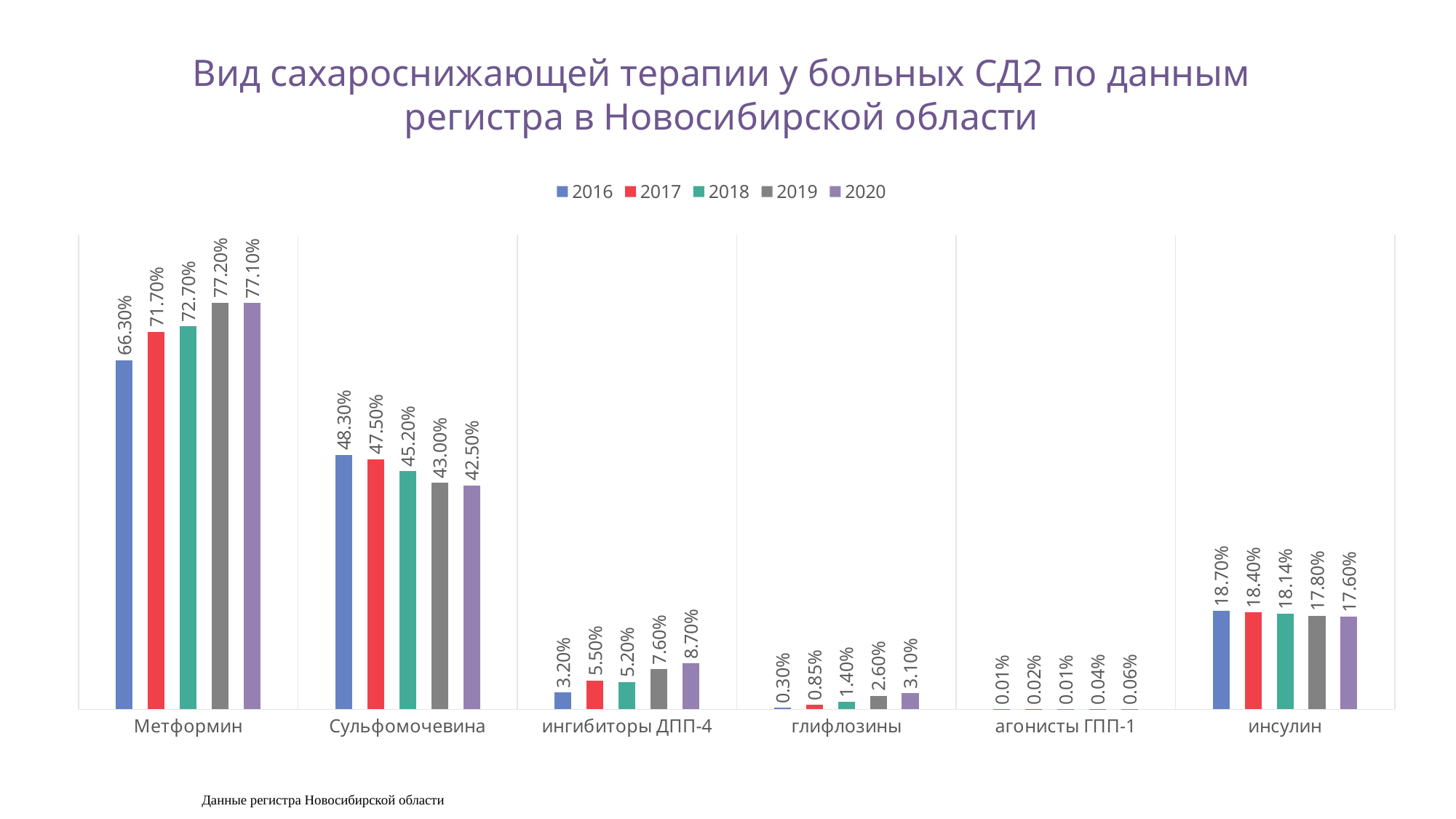
What is the value for инсулин in 2020? 17.60% How many series does the legend list? 5 Which category has the highest value in 2019? Метформин What is the value for глифлозины in 2018? 1.40% For Сульфомочевина, which year has the larger value, 2016 or 2017? 2016 What is the value for Метформин in 2016? 66.30% What kind of chart is shown on the slide? Bar chart What colour represents the 2017 series in the legend? Red Do the values for Сульфомочевина rise or fall from 2016 to 2020? Fall How many categories are shown on the x axis? 6 What is the difference between the 2020 and 2016 values for Метформин? 10.80% Which category has the lowest value in 2020? агонисты ГПП-1